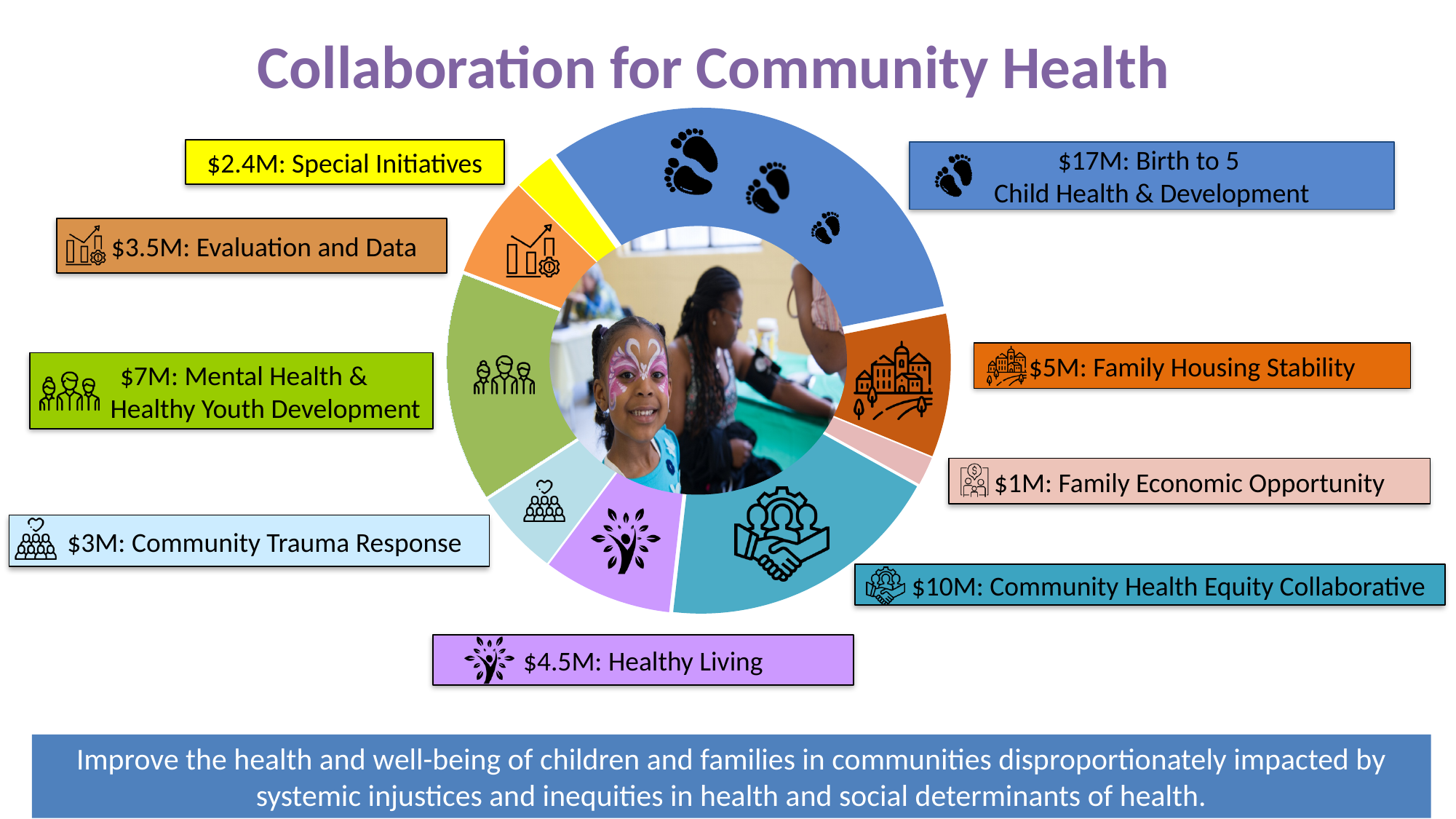
What is the value for Community Health Equity Collaborative? $10M What is the value for Evaluation and Data? $3.5M What kind of chart is shown on the slide? pie chart (donut) What is the difference between Special Initiatives and Community Trauma Response? $0.6M What is the title of the slide containing the chart? Collaboration for Community Health What is the value for Healthy Living? $4.5M Which is larger, Mental Health & Healthy Youth Development or Family Housing Stability? Mental Health & Healthy Youth Development What is the difference between Birth to 5 Child Health & Development and Community Health Equity Collaborative? $7M Which category has the smallest value? Family Economic Opportunity What is the value for Birth to 5 Child Health & Development? $17M Which category has the largest value? Birth to 5 Child Health & Development How many categories (segments) does the chart have? 9